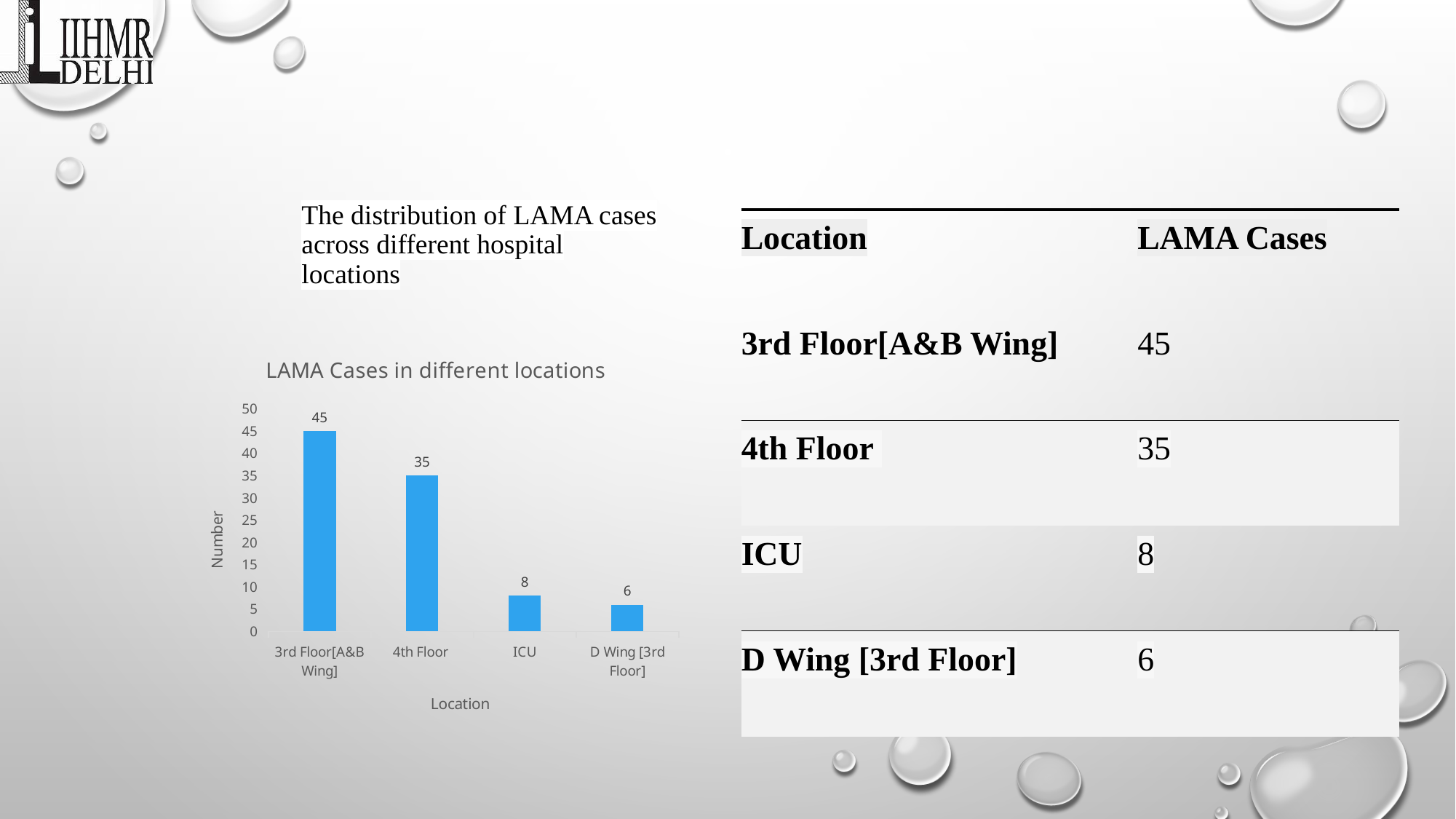
Which location has the highest number of LAMA cases? 3rd Floor[A&B Wing] What kind of chart is shown on the slide? Bar chart What is the value for 3rd Floor[A&B Wing] in the chart? 45 What is the value for ICU in the chart? 8 What is the difference between the values for 3rd Floor[A&B Wing] and 4th Floor? 10 Is the value for 4th Floor greater or less than 30? greater What is the title of the chart? LAMA Cases in different locations Which is larger, the value for ICU or the value for D Wing [3rd Floor]? ICU What is the value for 4th Floor in the chart? 35 What is the value for D Wing [3rd Floor] in the chart? 6 Which location has the lowest number of LAMA cases? D Wing [3rd Floor] How many locations are shown in the chart? 4